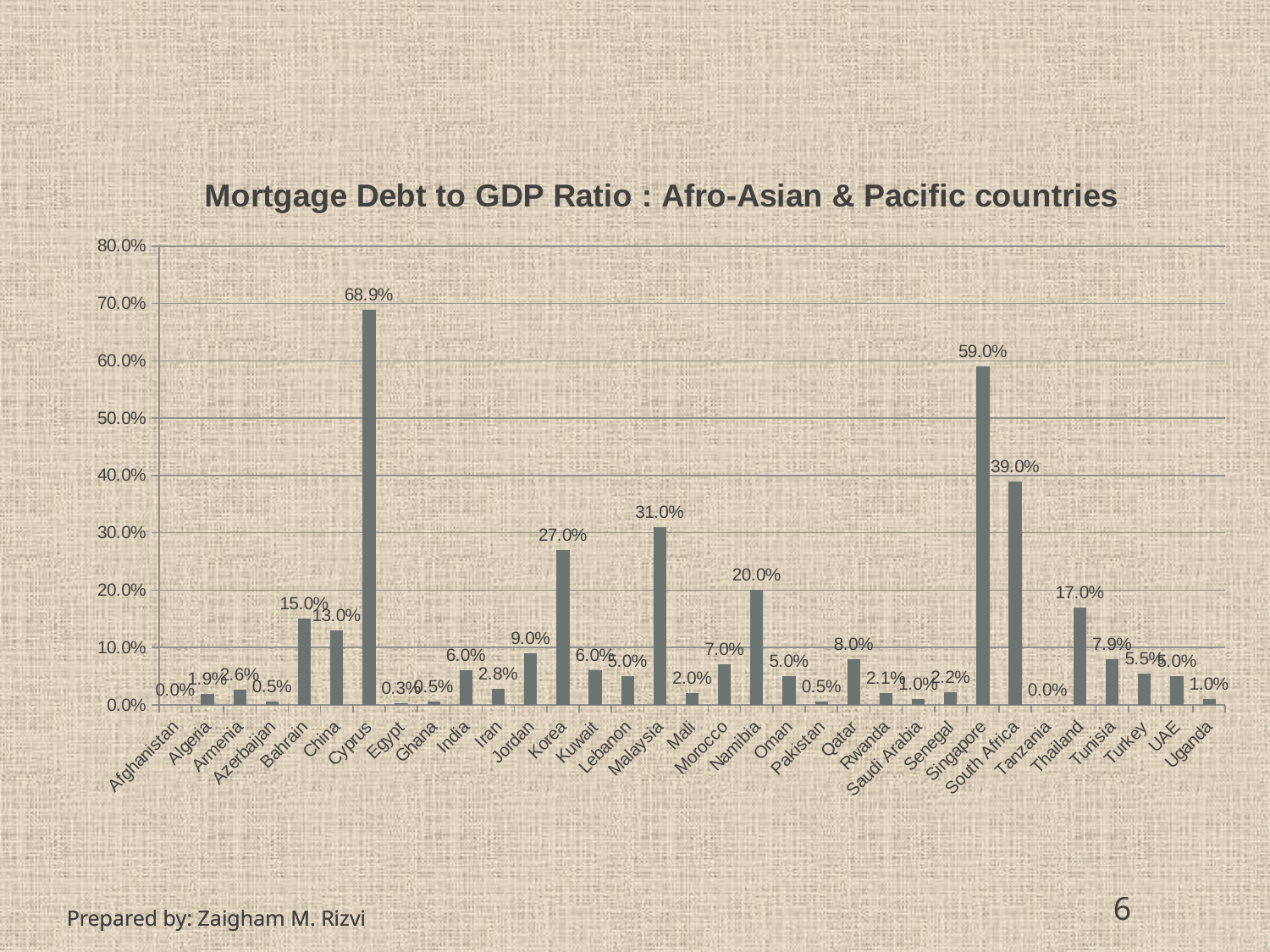
What is the difference between the values for South Africa and Namibia? 19.0% What is the mortgage debt to GDP ratio for Singapore? 59.0% What kind of chart is shown on the slide? Bar chart Is the value for South Africa greater or less than 30.0%? greater Which country has the highest mortgage debt to GDP ratio? Cyprus What is the title of the chart? Mortgage Debt to GDP Ratio : Afro-Asian & Pacific countries What is the mortgage debt to GDP ratio for Cyprus? 68.9% What is the value shown for Thailand? 17.0% What is the difference between the values for Cyprus and Singapore? 9.9% Which has a higher mortgage debt to GDP ratio, Korea or Malaysia? Malaysia How many countries are shown on the x axis? 33 What is the value shown for Malaysia? 31.0%